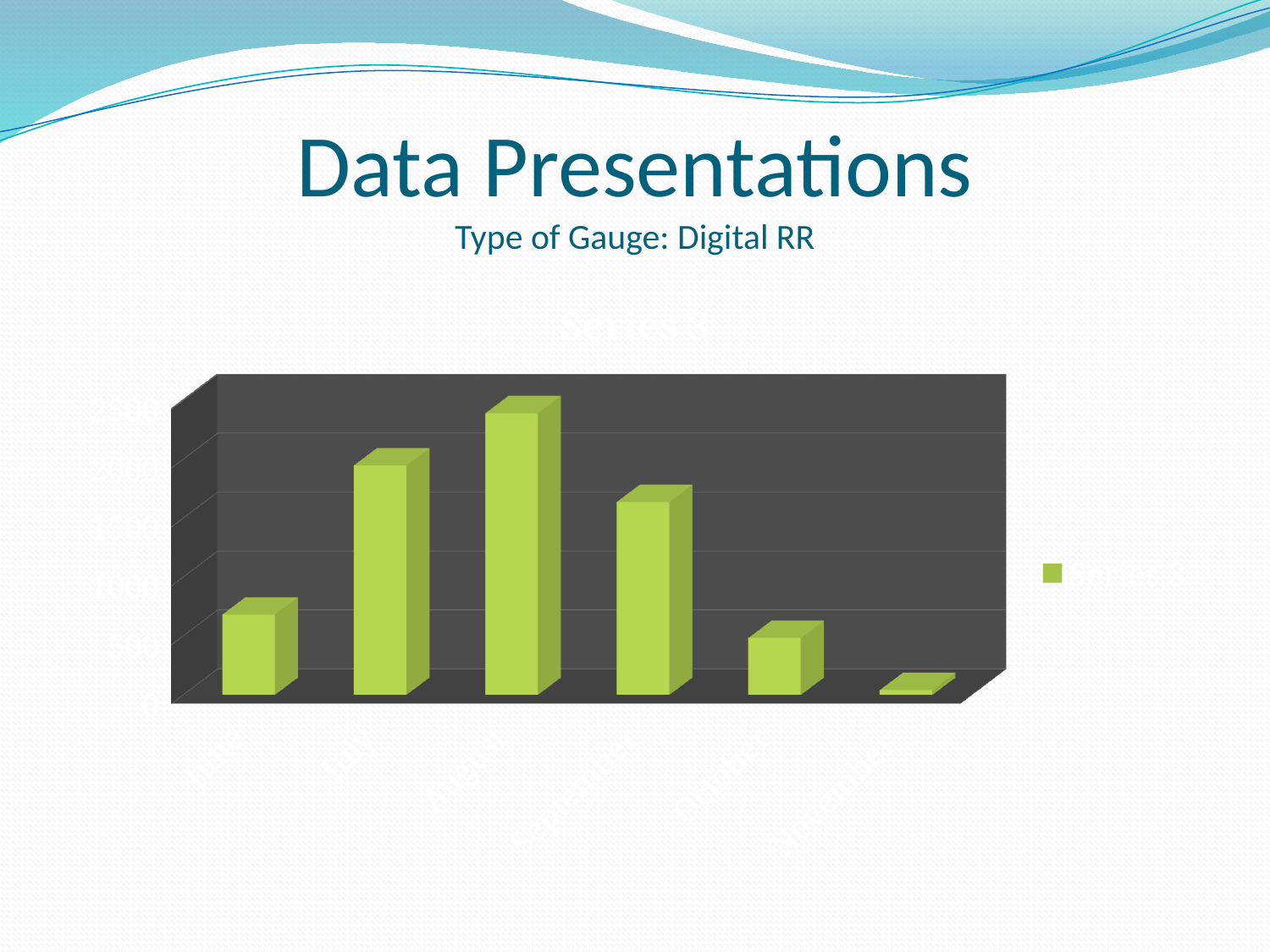
Which is larger, the value for June or the value for November? June Is the value for November greater or less than 500? less How many series does the chart's legend list? 1 Which is larger, the value for July or the value for September? July Do the values rise or fall from August to November? fall Is the value for June greater or less than 1000? less Which month has the lowest value in the chart? November How many categories are shown on the x axis of the chart? 6 What is the name of the series shown in the chart's legend? Series 3 Is the value for August greater or less than 2000? greater Which month has the highest value in the chart? August What kind of chart is shown on the slide? bar chart